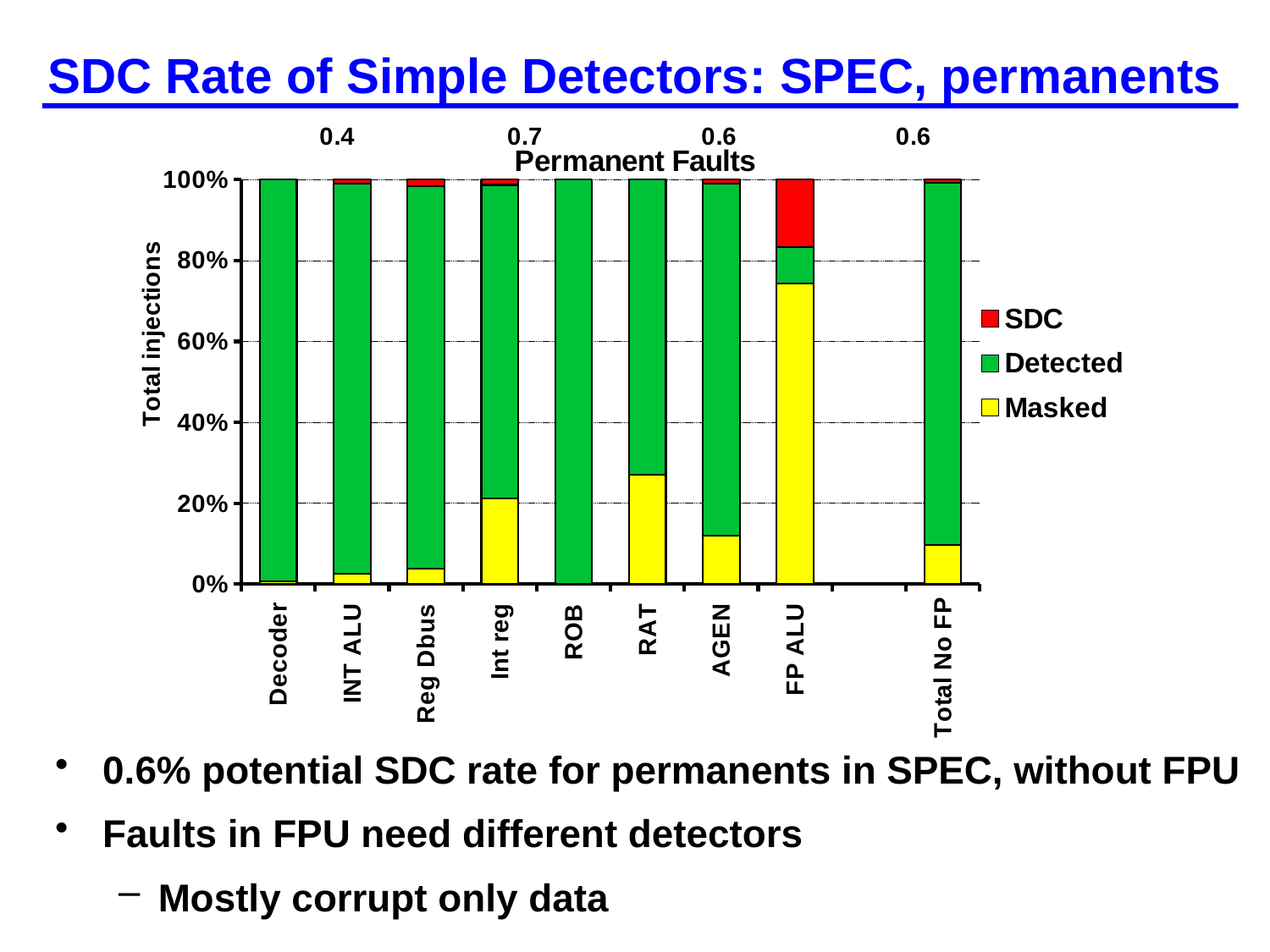
Is the Masked value for FP ALU greater or less than 60%? greater What is the title of the chart? Permanent Faults What is the total of the stacked bar for Decoder? 100% Is the Masked value for RAT greater or less than 20%? greater Which colour represents SDC in the legend? Red How many categories are shown along the x axis of the chart? 9 What kind of chart is shown on the slide? Stacked bar chart Is the Masked value for AGEN greater or less than 20%? less Which has the larger Masked share, FP ALU or RAT? FP ALU How many series does the chart's legend list? 3 Which category has the largest Masked share? FP ALU